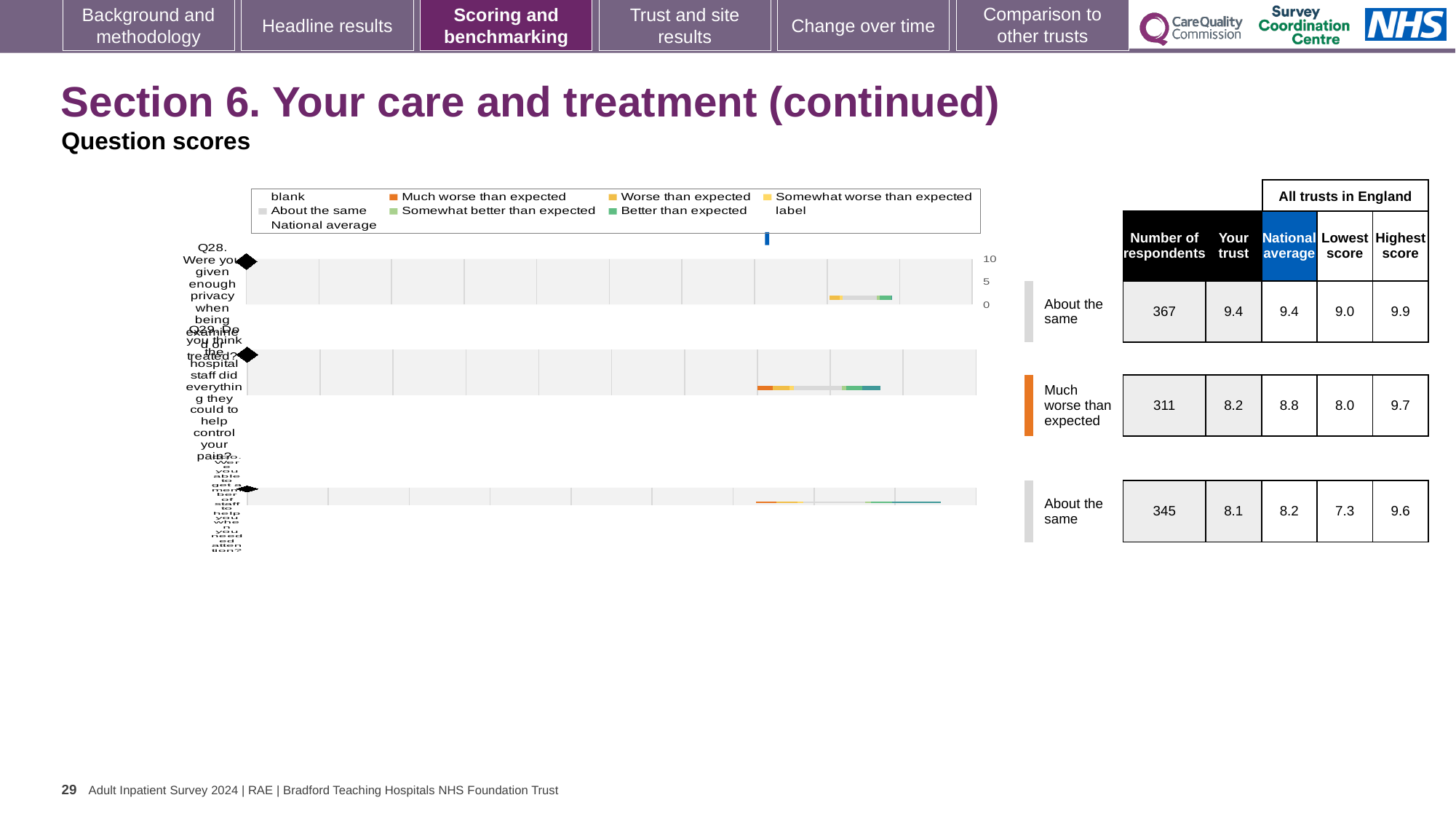
Which question has the lowest 'Your trust' score? Q30 Is the 'Your trust' score for Q28 greater or less than 5 on the chart axis? greater What is the 'Your trust' score for Q28 (privacy when being examined or treated)? 9.4 What benchmark category is shown for Q29? Much worse than expected What is the national average score for Q29 (staff did everything to help control your pain)? 8.8 What is the difference between the national average and the 'Your trust' score for Q29? 0.6 Which is larger, the 'Your trust' score for Q28 or for Q30? Q28 How many questions (categories) are plotted on the chart? 3 How many entries does the chart legend list? 9 How many respondents answered Q29? 311 What kind of chart is shown on the slide? bar chart Which question has the highest 'Your trust' score? Q28